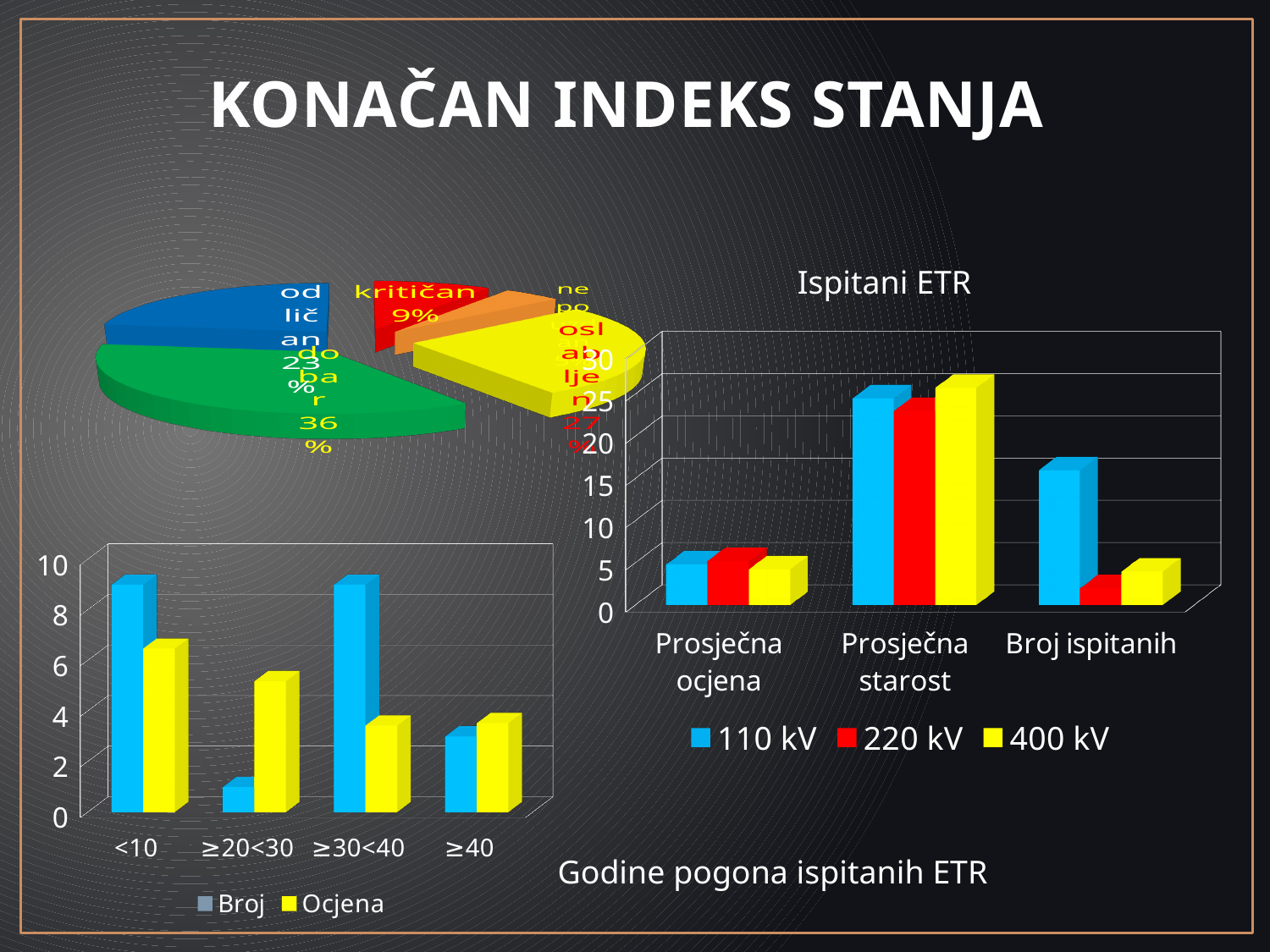
How many categories are shown on the x axis of the 'Ispitani ETR' chart? 3 In the pie chart at the top left, what percentage is shown for the 'odličan' slice? 23% In the pie chart at the top left, what percentage is shown for the 'dobar' slice? 36% What kind of chart is the 'Godine pogona ispitanih ETR' chart at the bottom left? bar chart In the pie chart at the top left, which is larger, the 'odličan' slice or the 'kritičan' slice? odličan In the 'Godine pogona ispitanih ETR' chart, is the 'Broj' value for '<10' greater or less than 8? greater In the 'Ispitani ETR' chart, is the 400 kV value for 'Prosječna starost' greater or less than 20? greater In the 'Ispitani ETR' chart, is the 110 kV value for 'Broj ispitanih' greater or less than 10? greater In the 'Ispitani ETR' chart, which series has the lowest value for 'Broj ispitanih'? 220 kV In the pie chart at the top left, what percentage is shown for the 'kritičan' slice? 9% How many series does the legend of the 'Ispitani ETR' chart list? 3 In the 'Godine pogona ispitanih ETR' chart, which category has the lowest 'Broj' value? ≥20<30